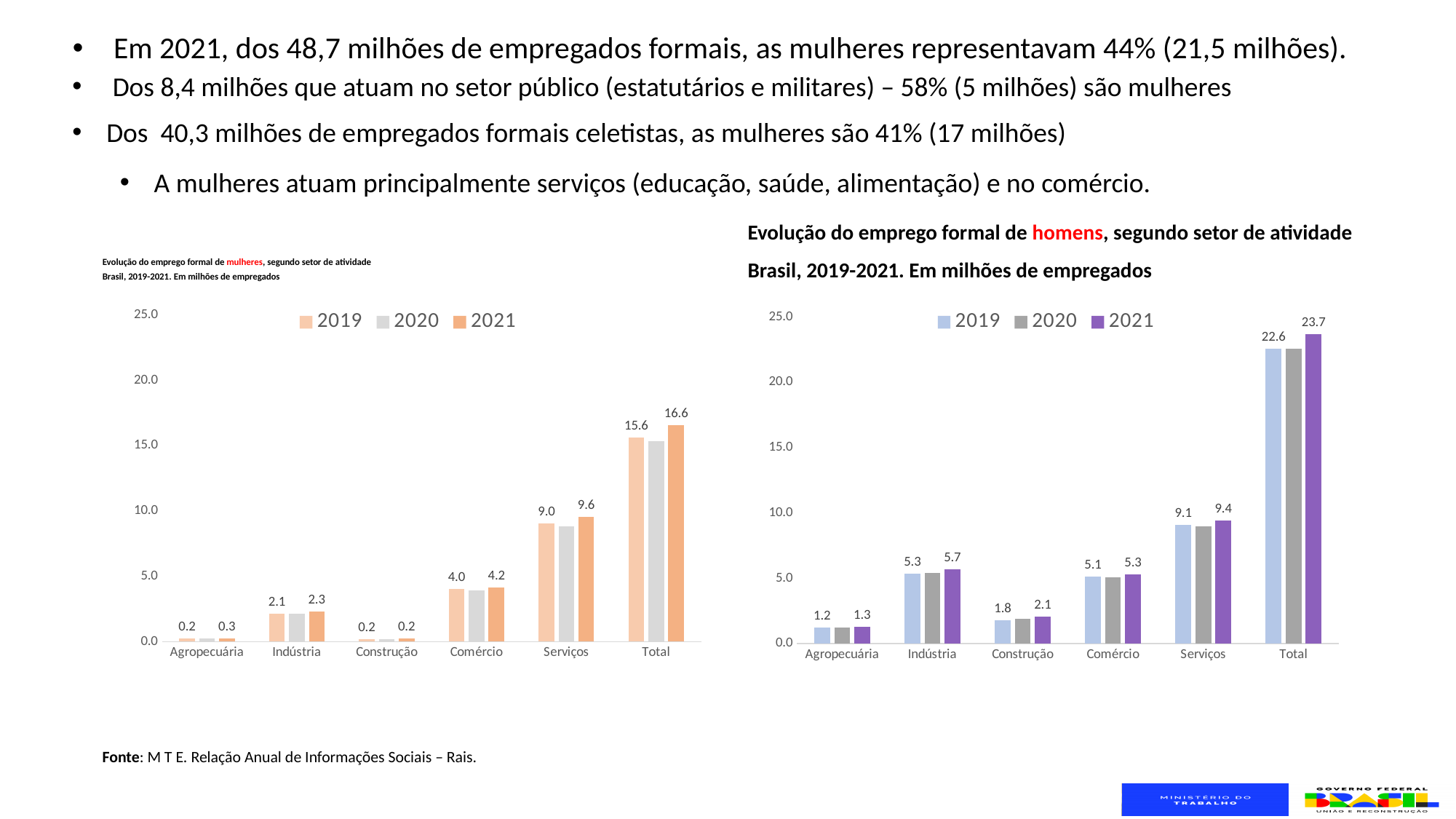
In the chart on the right (men's formal employment), is the 2020 value for Total greater or less than 20.0? greater In the chart on the right (men's formal employment), what is the 2019 value for Total? 22.6 What kind of chart is the chart on the right (men's formal employment)? Bar chart In the chart on the right (men's formal employment), what is the 2021 value for Indústria? 5.7 In the chart on the left (women's formal employment), what is the 2019 value for Comércio? 4.0 In the chart on the left (women's formal employment), excluding Total, which sector has the highest 2021 value? Serviços In the chart on the left (women's formal employment), what is the difference between the 2021 and 2019 values for Total? 1.0 In the chart on the right (men's formal employment), excluding Total, which sector has the lowest 2021 value? Agropecuária How many series does the legend of the chart on the left list? 3 In the chart on the right (men's formal employment), what is the difference between the 2021 and 2019 values for Construção? 0.3 In the chart on the left (women's formal employment), what is the 2021 value for Serviços? 9.6 Which is larger: the 2021 value for Serviços in the women's chart (left) or the 2021 value for Serviços in the men's chart (right)? Women's chart (9.6)